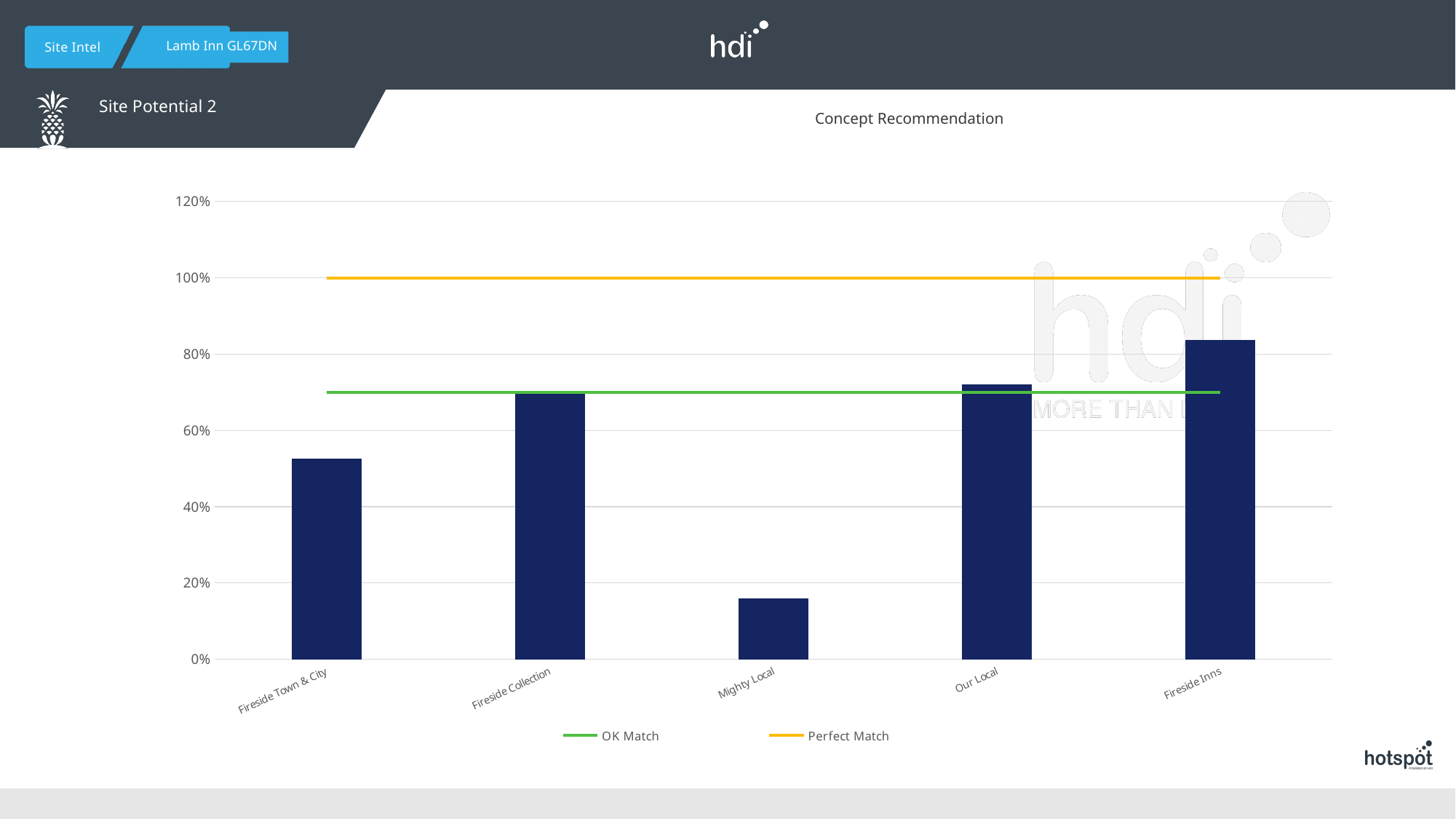
Which is larger, the bar for Fireside Town & City or the bar for Mighty Local? Fireside Town & City What is the title of the chart? Concept Recommendation What kind of chart is shown on the slide? Bar chart Which concept has the lowest bar? Mighty Local Is the value for Fireside Inns greater or less than 80%? greater How many concept categories are plotted on the x axis? 5 Is the value for Fireside Town & City greater or less than 60%? less Which concept has the highest bar? Fireside Inns How many entries does the chart legend list? 2 Is the value for Our Local greater or less than 60%? greater Which is larger, the bar for Fireside Inns or the bar for Our Local? Fireside Inns